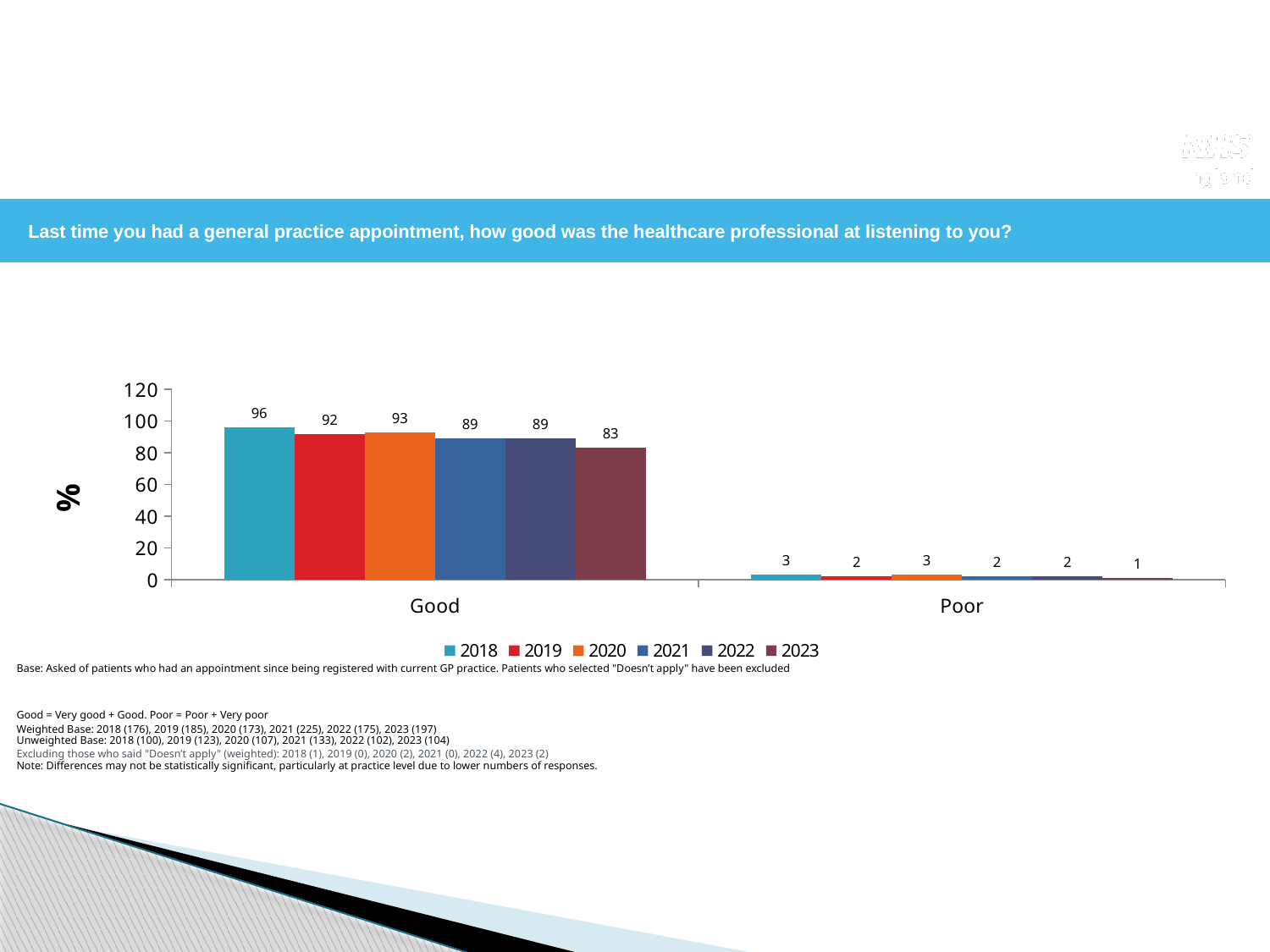
What is the difference between the 2018 and 2023 values in the Good category? 13 What is the label on the vertical axis? % Which year has the highest value in the Good category? 2018 What kind of chart is shown on the slide? Bar chart Which is larger in the Good category, the value for 2019 or the value for 2020? 2020 What is the value for 2020 in the Poor category? 3 How many series does the legend list? 6 Is the value for 2023 in the Good category greater or less than 80? greater How many categories are shown on the x axis? 2 Which year has the lowest value in the Good category? 2023 What is the value for 2018 in the Good category? 96 What is the value for 2023 in the Good category? 83